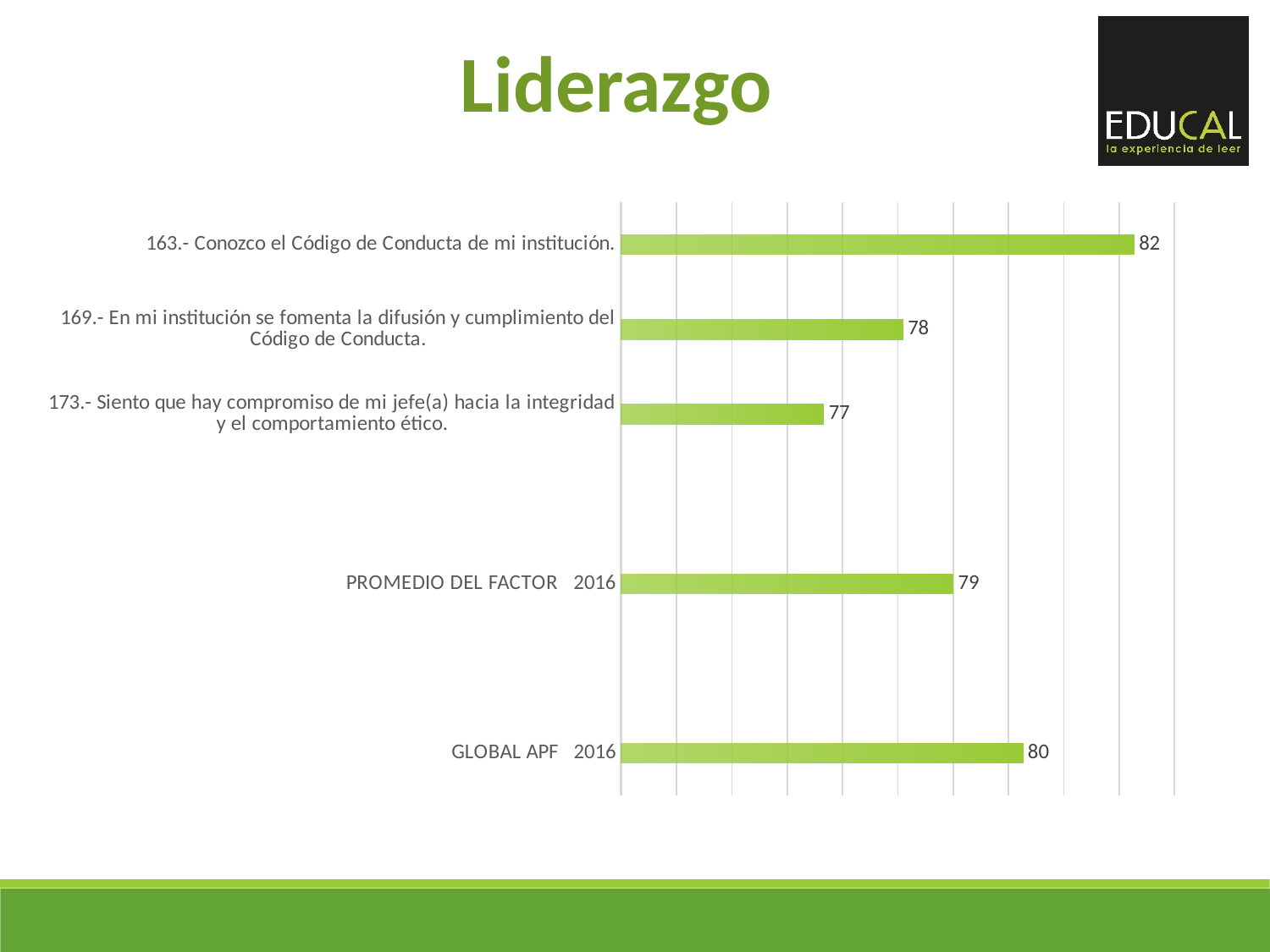
How many bars are plotted in the chart? 5 What is the value for '173.- Siento que hay compromiso de mi jefe(a) hacia la integridad y el comportamiento ético.'? 77 What kind of chart is shown on the slide? Bar chart Which category has the highest value? 163.- Conozco el Código de Conducta de mi institución. What is the difference between 'GLOBAL APF 2016' and 'PROMEDIO DEL FACTOR 2016'? 1 Which is larger, the value for 'PROMEDIO DEL FACTOR 2016' or the value for 'GLOBAL APF 2016'? GLOBAL APF 2016 Which category has the lowest value? 173.- Siento que hay compromiso de mi jefe(a) hacia la integridad y el comportamiento ético. What is the value for '169.- En mi institución se fomenta la difusión y cumplimiento del Código de Conducta.'? 78 What is the value for 'GLOBAL APF 2016'? 80 What is the value for 'PROMEDIO DEL FACTOR 2016'? 79 What is the difference between the value for item 163 and the value for item 173? 5 What is the value for '163.- Conozco el Código de Conducta de mi institución.'? 82